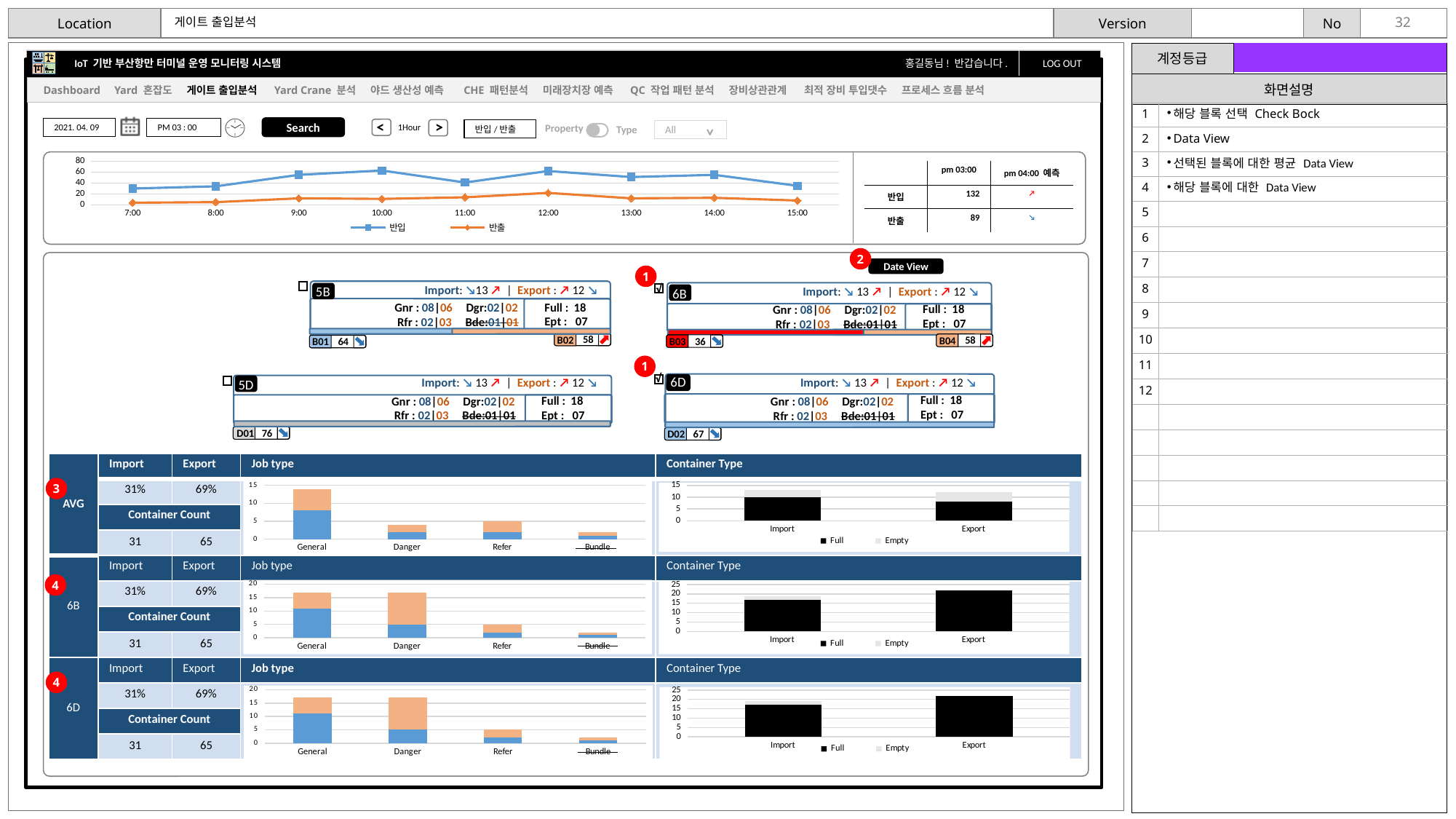
In the AVG Job type chart, which category has the shortest bar? Bundle In the top line chart, which series is higher at 12:00, 반입 or 반출? 반입 In the top line chart, at which time is the 반출 value highest? 12:00 In the top line chart, how many series does the legend list? 2 In the top line chart, is the 반출 value at 7:00 greater or less than 20? less In the AVG Job type chart, which category has the tallest bar? General In the top line chart, is the 반입 value at 10:00 greater or less than 40? greater What kind of chart is the chart at the top of the slide showing 반입 and 반출 from 7:00 to 15:00? line chart In the AVG Job type chart, is the total for General greater or less than 10? greater In the AVG Container Type chart, what are the two legend entries? Full, Empty In the top line chart, how many time points are shown on the x axis? 9 In the AVG Job type chart, how many categories are shown on the x axis? 4